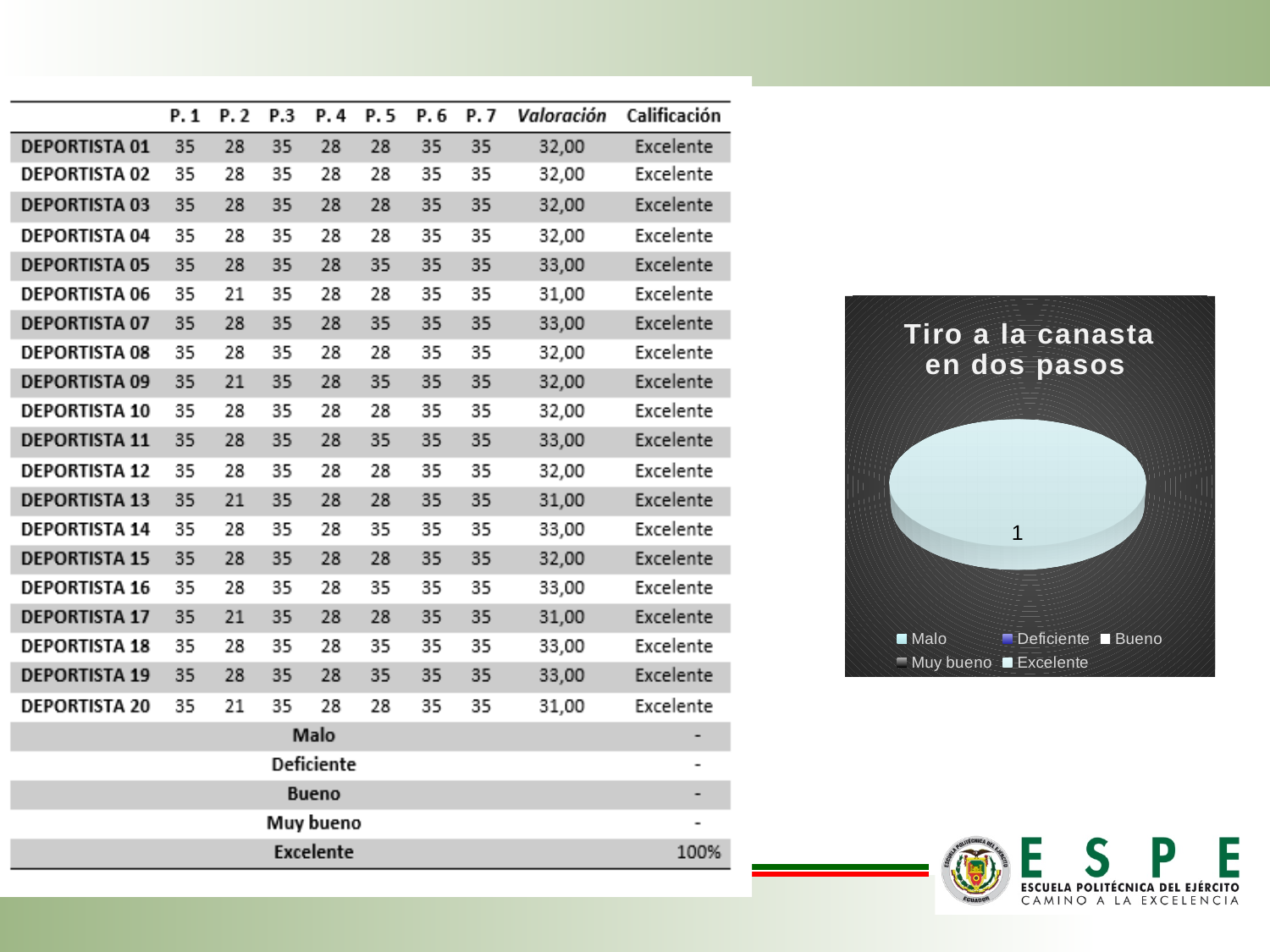
What data label is printed on the pie slice? 1 How many slices are visible in the pie chart? 1 What kind of chart is shown on the slide? pie chart Which category fills the entire pie chart? Excelente What is the title of the pie chart? Tiro a la canasta en dos pasos How many entries does the legend of the pie chart list? 5 Which legend entry is listed first in the pie chart's legend? Malo What share of the pie does Excelente take? 100%